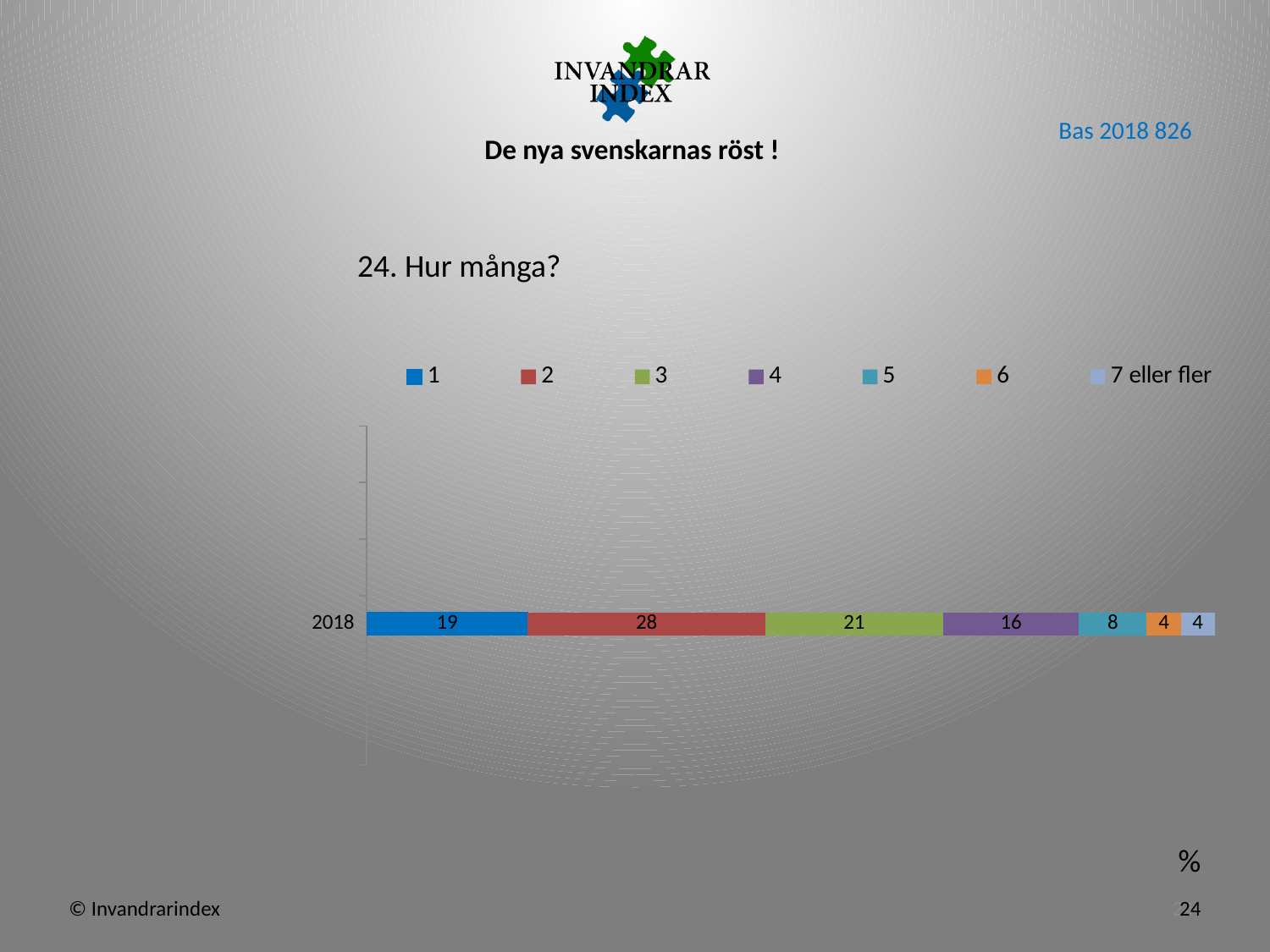
Which is larger in the 2018 bar, the value for series "3" or series "1"? 3 What is the title of the chart? 24. Hur många? Which series has the highest value in the 2018 bar? 2 What type of chart is shown on the slide? stacked bar chart How many series does the legend list? 7 What is the value for series "1" in the 2018 bar? 19 What is the total of the stacked bar for 2018? 100 What is the value for series "7 eller fler" in the 2018 bar? 4 What is the value for series "4" in the 2018 bar? 16 What is the value for series "2" in the 2018 bar? 28 How many categories are shown on the vertical axis of the chart? 1 What is the difference between the values for series "2" and series "3" in the 2018 bar? 7